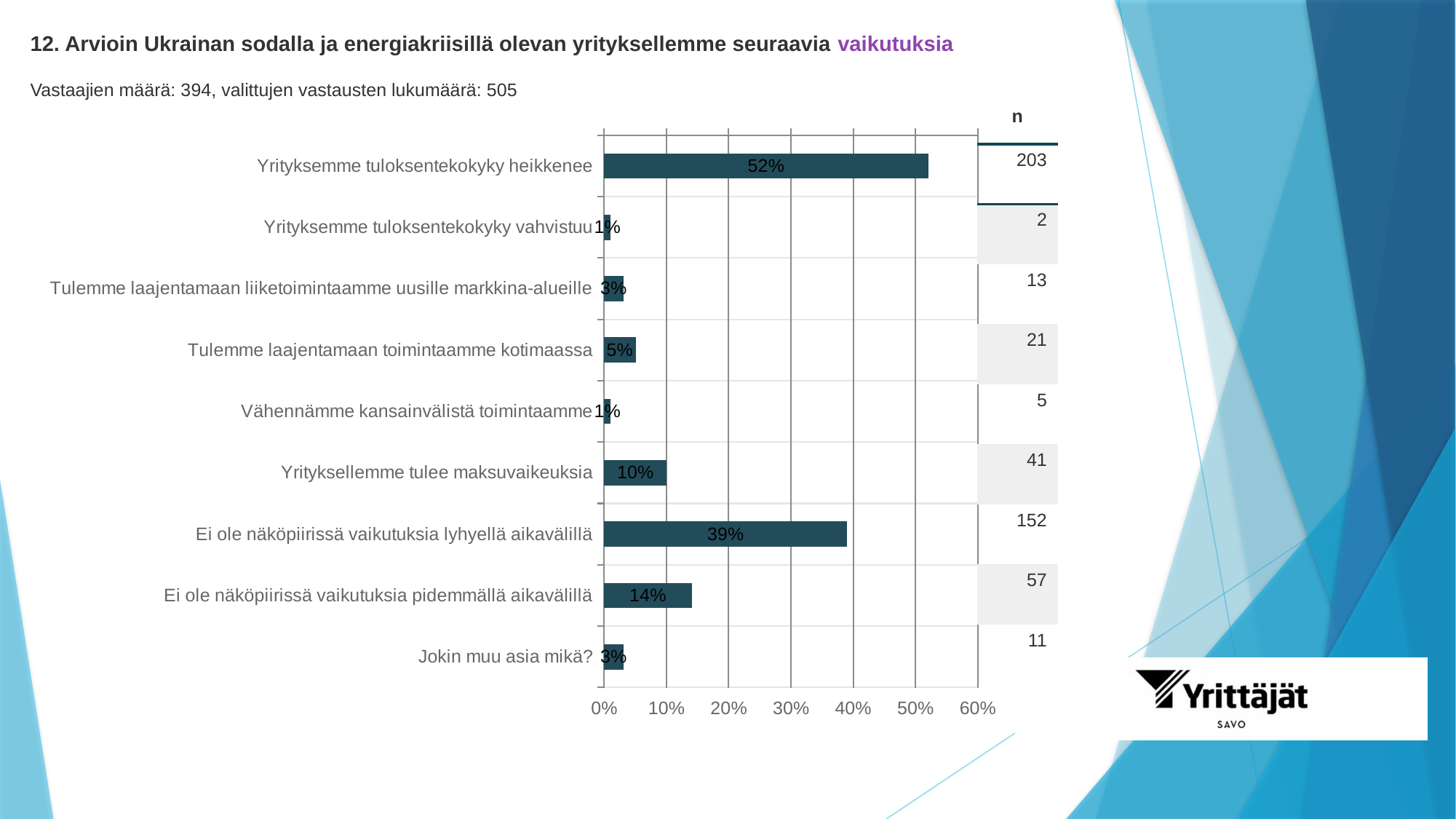
What percentage is shown for "Yrityksemme tuloksentekokyky heikkenee"? 52% Is the value for "Ei ole näköpiirissä vaikutuksia pidemmällä aikavälillä" greater or less than 20%? less What is the highest value shown on the percentage axis? 60% What percentage is shown for "Yrityksellemme tulee maksuvaikeuksia"? 10% What is the difference in percentage points between "Yrityksemme tuloksentekokyky heikkenee" and "Ei ole näköpiirissä vaikutuksia lyhyellä aikavälillä"? 13% What percentage is shown for "Ei ole näköpiirissä vaikutuksia lyhyellä aikavälillä"? 39% What is the n value for "Yrityksemme tuloksentekokyky heikkenee"? 203 How many categories are shown in the chart? 9 What kind of chart is shown on the slide? bar chart Which category has the highest percentage? Yrityksemme tuloksentekokyky heikkenee What is the n value for "Ei ole näköpiirissä vaikutuksia pidemmällä aikavälillä"? 57 Which is larger: the percentage for "Tulemme laajentamaan toimintaamme kotimaassa" or for "Tulemme laajentamaan liiketoimintaamme uusille markkina-alueille"? Tulemme laajentamaan toimintaamme kotimaassa